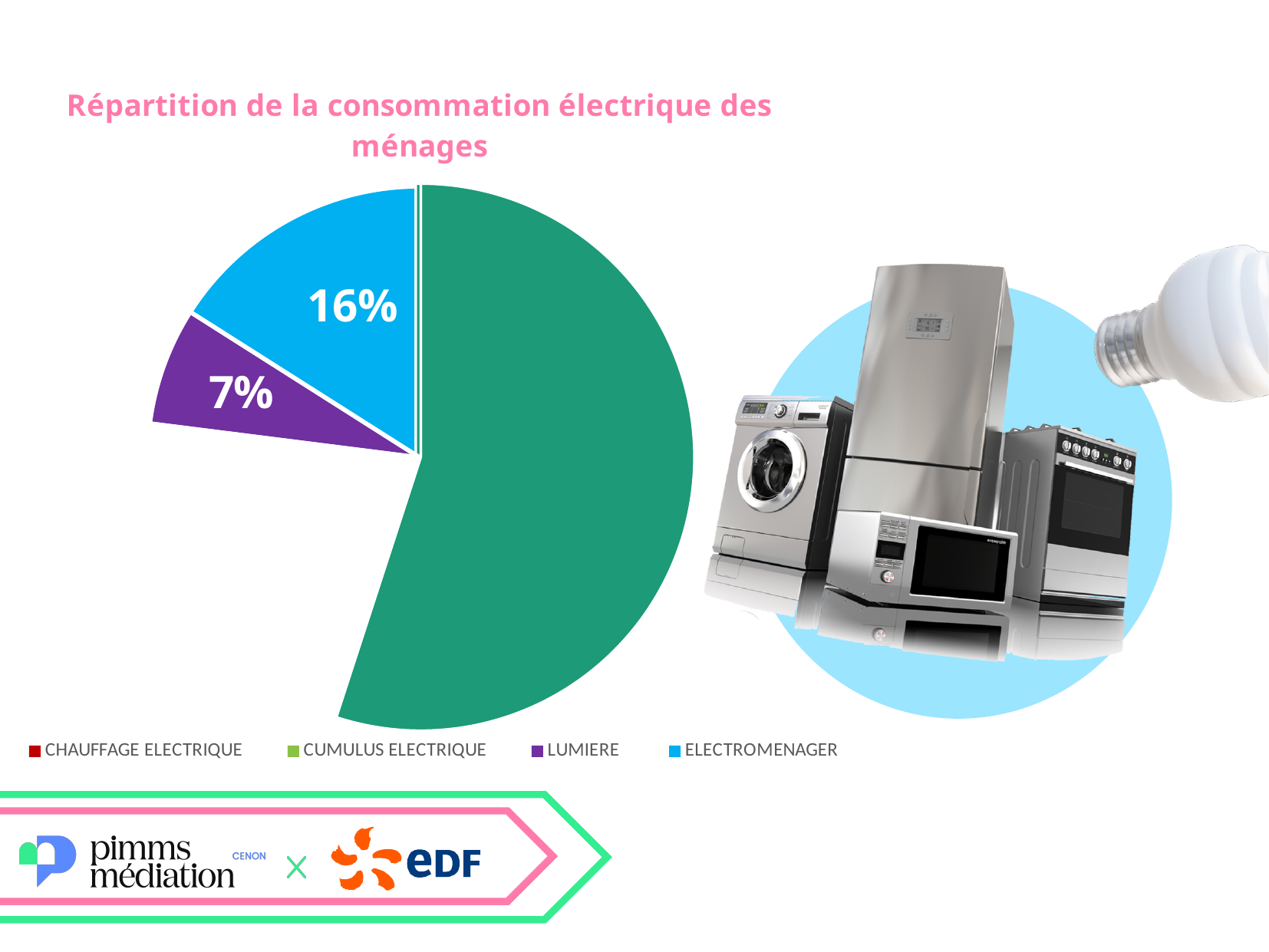
What is the title of the chart? Répartition de la consommation électrique des ménages What percentage does the ELECTROMENAGER slice represent in the pie chart? 16% Which has the larger share in the pie chart, LUMIERE or ELECTROMENAGER? ELECTROMENAGER How many categories does the chart legend list? 4 What type of chart is shown on the slide? Pie chart What colour is the LUMIERE slice in the pie chart? Purple What percentage does the LUMIERE slice represent in the pie chart? 7% Of the slices with a printed value, which one is the smallest? LUMIERE By how many percentage points does the ELECTROMENAGER share exceed the LUMIERE share? 9 percentage points